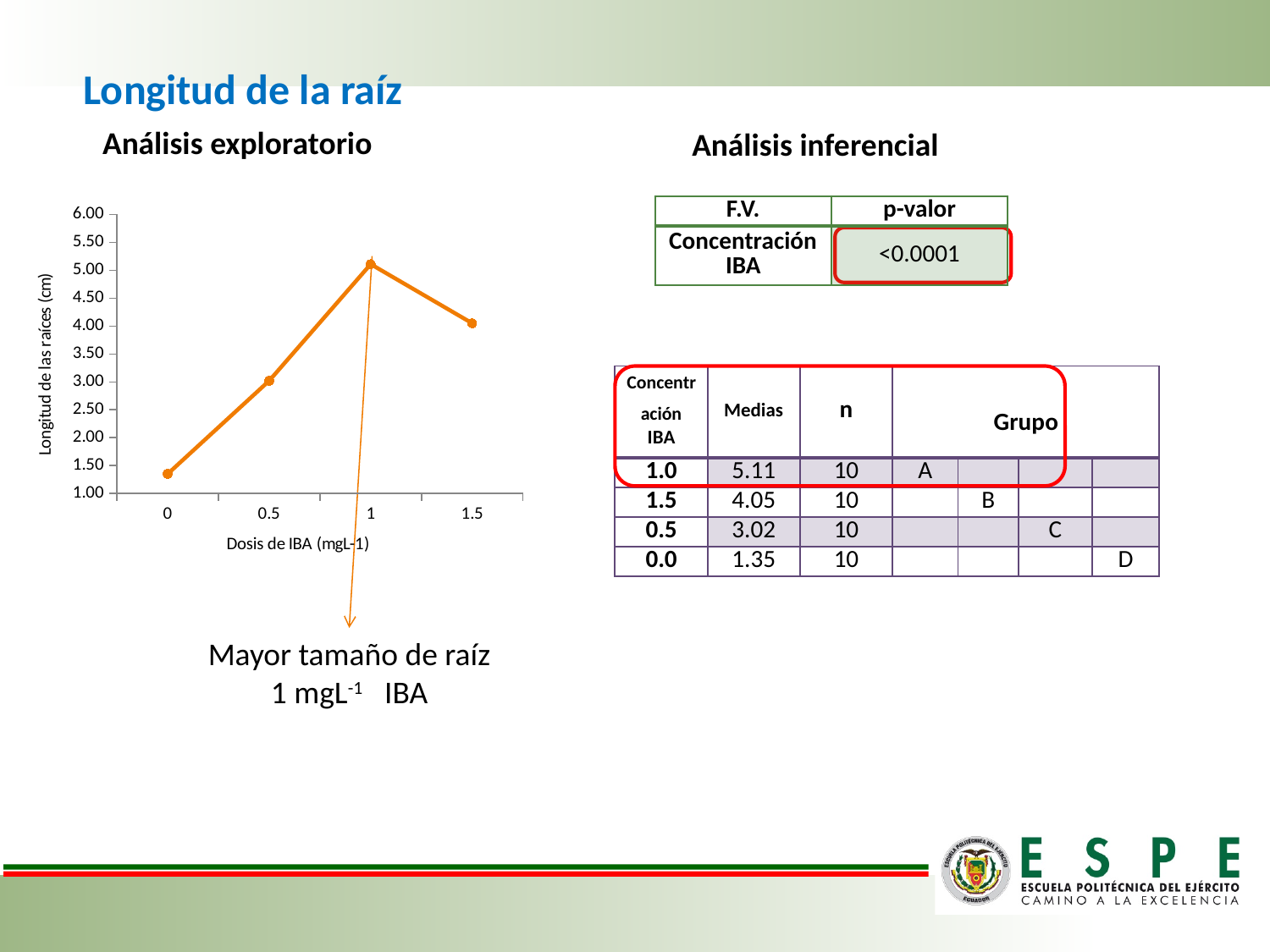
On the line chart, is the root length at dose 1.5 greater or less than 4.50? less On the line chart, is the root length at dose 1 greater or less than 4.50? greater On the line chart, is the root length at dose 0.5 greater or less than 2.50? greater What kind of chart is shown under "Análisis exploratorio"? line chart How does root length change along the x axis of the line chart? rises from dose 0 to 1, then falls at 1.5 At which IBA dose does the line chart show the lowest root length? 0 At which IBA dose does the line chart reach its highest root length? 1 On the line chart, which dose has the larger root length, 1 or 1.5? 1 How many data points are plotted on the line chart? 4 On the line chart, which dose has the larger root length, 0.5 or 1.5? 1.5 What is the y-axis title of the line chart? Longitud de las raíces (cm)